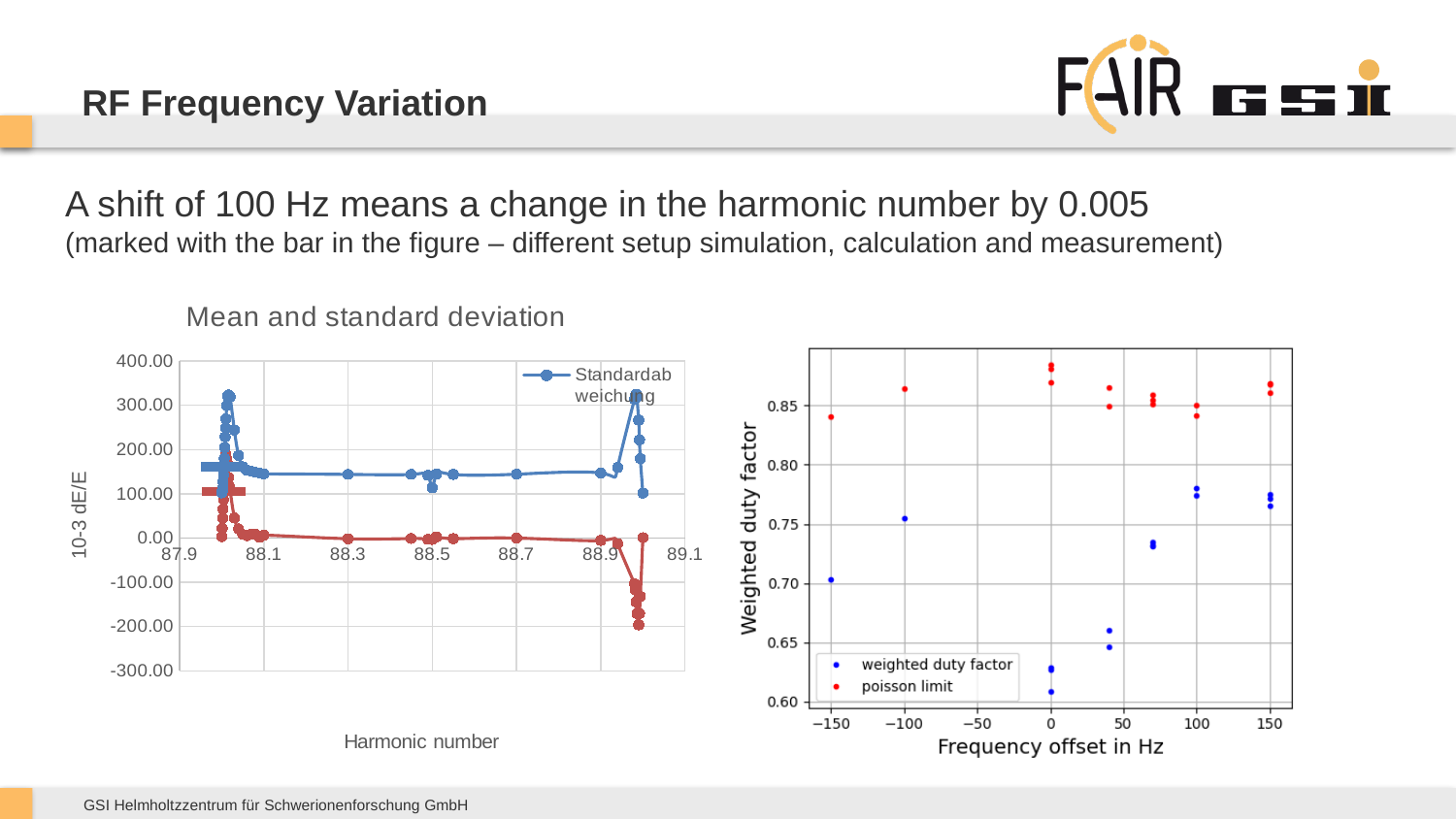
In the chart on the right, at which frequency offset is the weighted duty factor lowest? 0 Hz In the chart on the left, is the red series value at harmonic number 88.3 greater or less than 100.00? less What kind of chart is the chart on the right of the slide? scatter chart In the chart on the right, is the poisson limit at a frequency offset of -150 Hz greater or less than 0.80? greater What is the title of the chart on the left of the slide? Mean and standard deviation In the chart on the right, what is the label of the x axis? Frequency offset in Hz In the chart on the right, how many series does the legend list? 2 What kind of chart is the chart on the left of the slide? line chart In the chart on the right, is the weighted duty factor at a frequency offset of -150 Hz greater or less than 0.75? less In the chart on the right, at a frequency offset of -150 Hz, which is larger: the weighted duty factor or the poisson limit? poisson limit